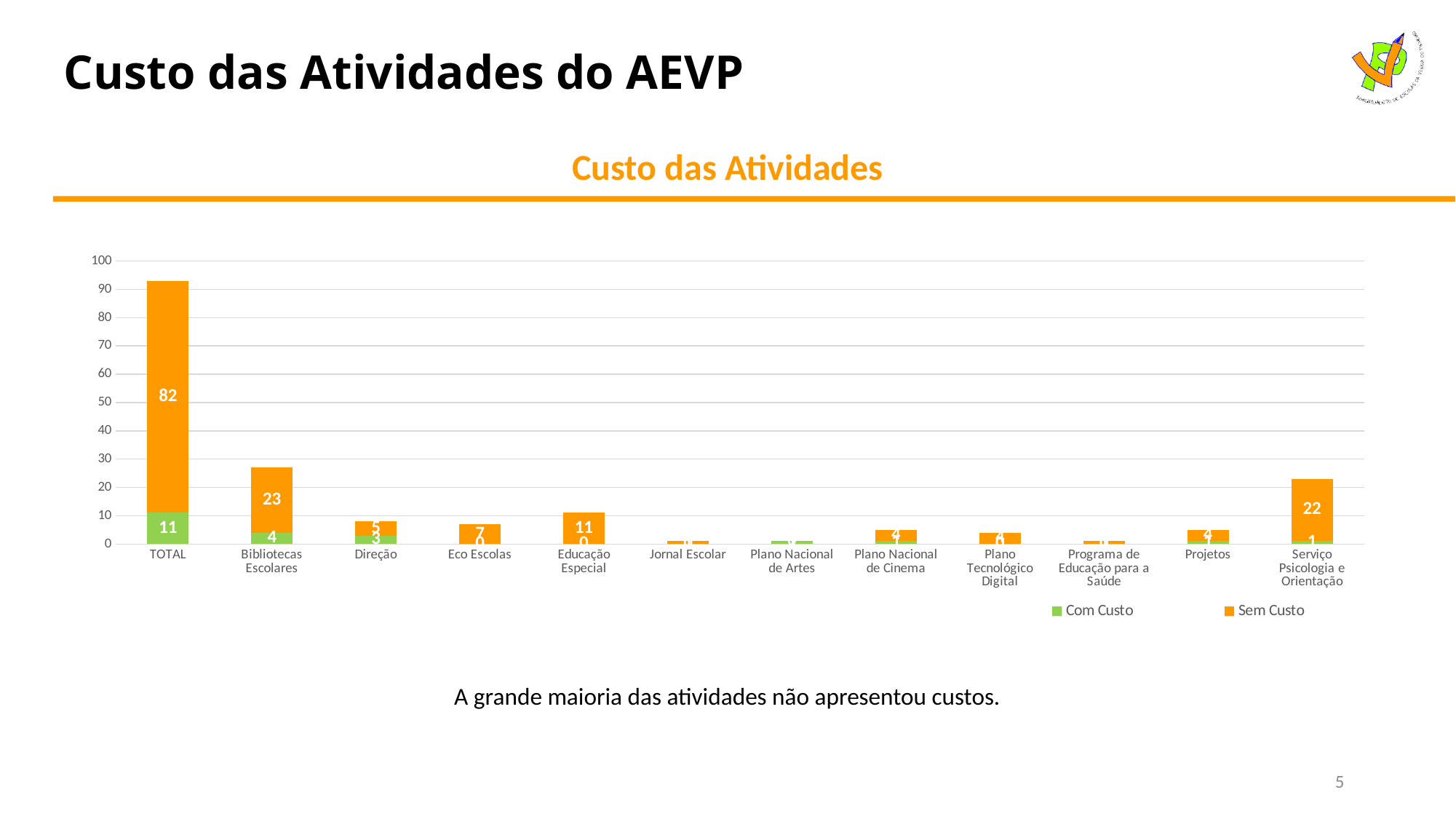
How many series does the legend list? 2 What is the Sem Custo value for Serviço Psicologia e Orientação? 22 Excluding TOTAL, which category has the highest Sem Custo value? Bibliotecas Escolares What is the difference between the Sem Custo values for Bibliotecas Escolares and Serviço Psicologia e Orientação? 1 What is the Com Custo value for TOTAL? 11 What is the Sem Custo value for Bibliotecas Escolares? 23 What is the total of the stacked bar for TOTAL? 93 What kind of chart is shown on the slide? Stacked bar chart How many categories are shown on the x axis? 12 What is the Com Custo value for Direção? 3 What is the Sem Custo value for TOTAL? 82 What are the two series named in the legend? Com Custo and Sem Custo